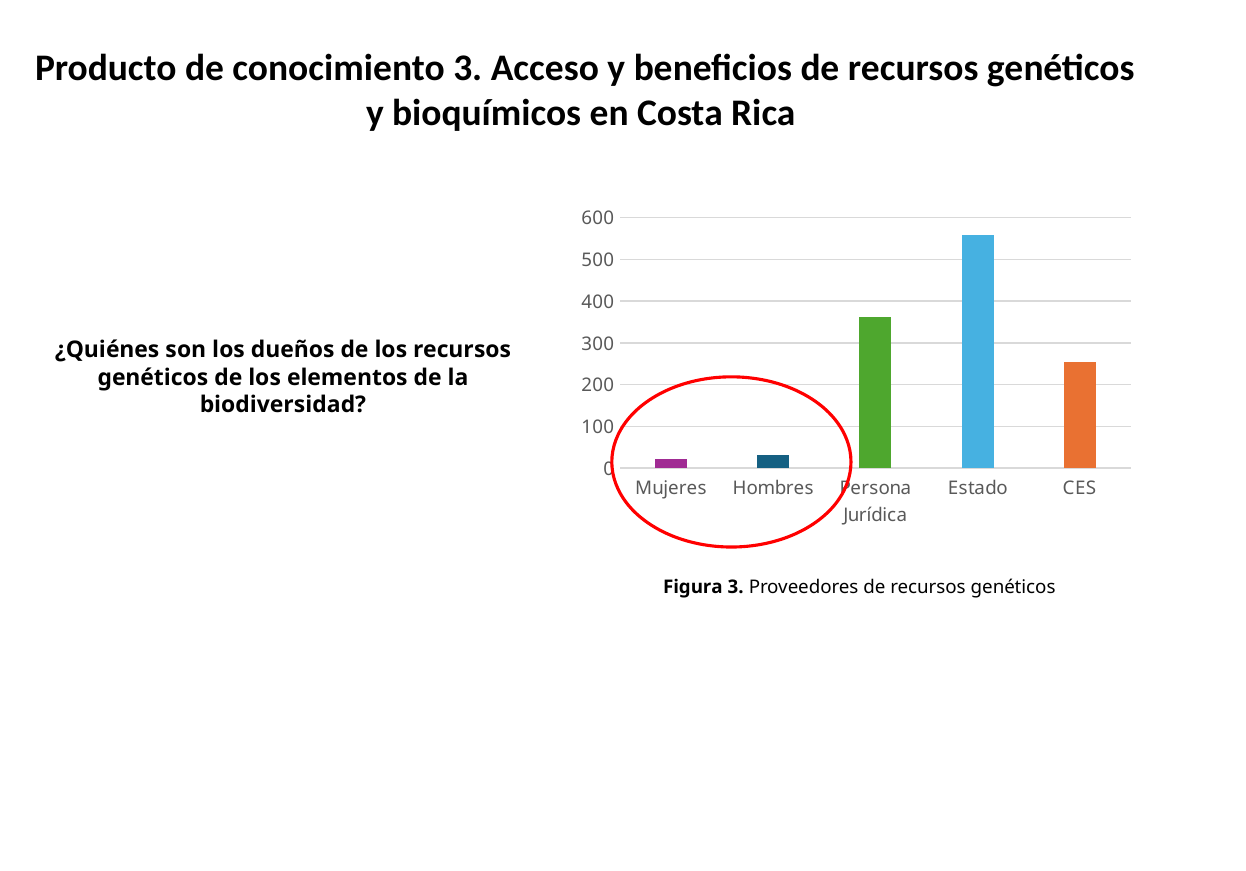
Is the value for CES greater or less than 300? less What kind of chart is shown on the slide? bar chart Is the value for CES greater or less than 200? greater Which is larger, the value for Estado or the value for Persona Jurídica? Estado Which category has the highest value in the chart? Estado Which is larger, the value for Persona Jurídica or the value for CES? Persona Jurídica Is the value for Estado greater or less than 500? greater What is the caption given below the chart? Figura 3. Proveedores de recursos genéticos Which two categories are circled in red on the chart? Mujeres and Hombres How many categories are shown on the x axis of the chart? 5